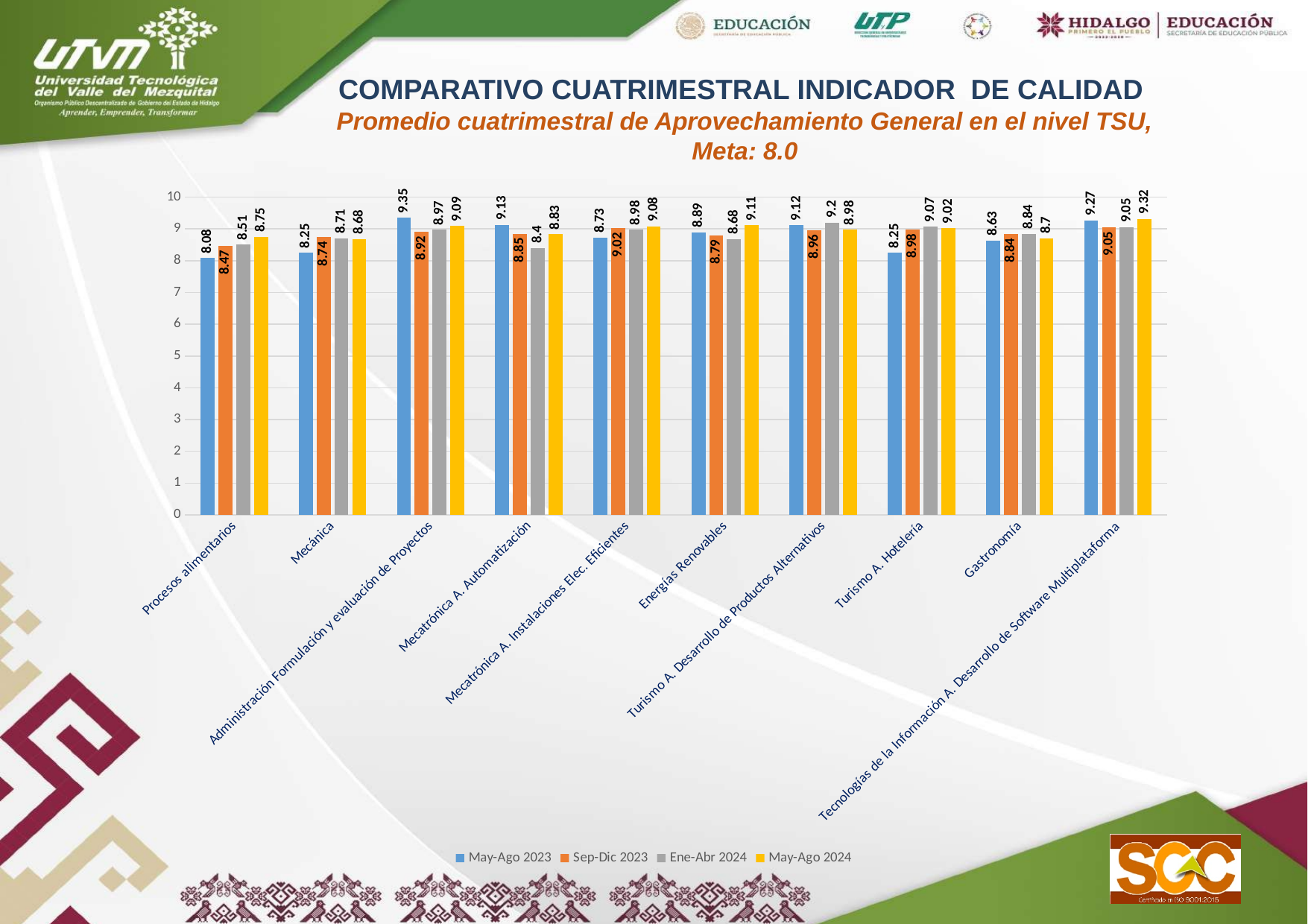
What is the value for Procesos alimentarios in the May-Ago 2023 series? 8.08 Which category has the highest value in the May-Ago 2024 series? Tecnologías de la Información A. Desarrollo de Software Multiplataforma What is the May-Ago 2024 value for Tecnologías de la Información A. Desarrollo de Software Multiplataforma? 9.32 Which category has the lowest value in the May-Ago 2023 series? Procesos alimentarios What is the target (Meta) stated in the chart subtitle? 8.0 How many categories (programs) are shown on the x axis? 10 Which is larger for Energías Renovables: the Sep-Dic 2023 value or the May-Ago 2024 value? May-Ago 2024 What is the Ene-Abr 2024 value for Mecatrónica A. Automatización? 8.4 How many series does the legend list? 4 Is the Ene-Abr 2024 value for Turismo A. Desarrollo de Productos Alternativos greater or less than 9? greater What is the difference between the May-Ago 2023 and May-Ago 2024 values for Procesos alimentarios? 0.67 What kind of chart is shown on the slide? Bar chart